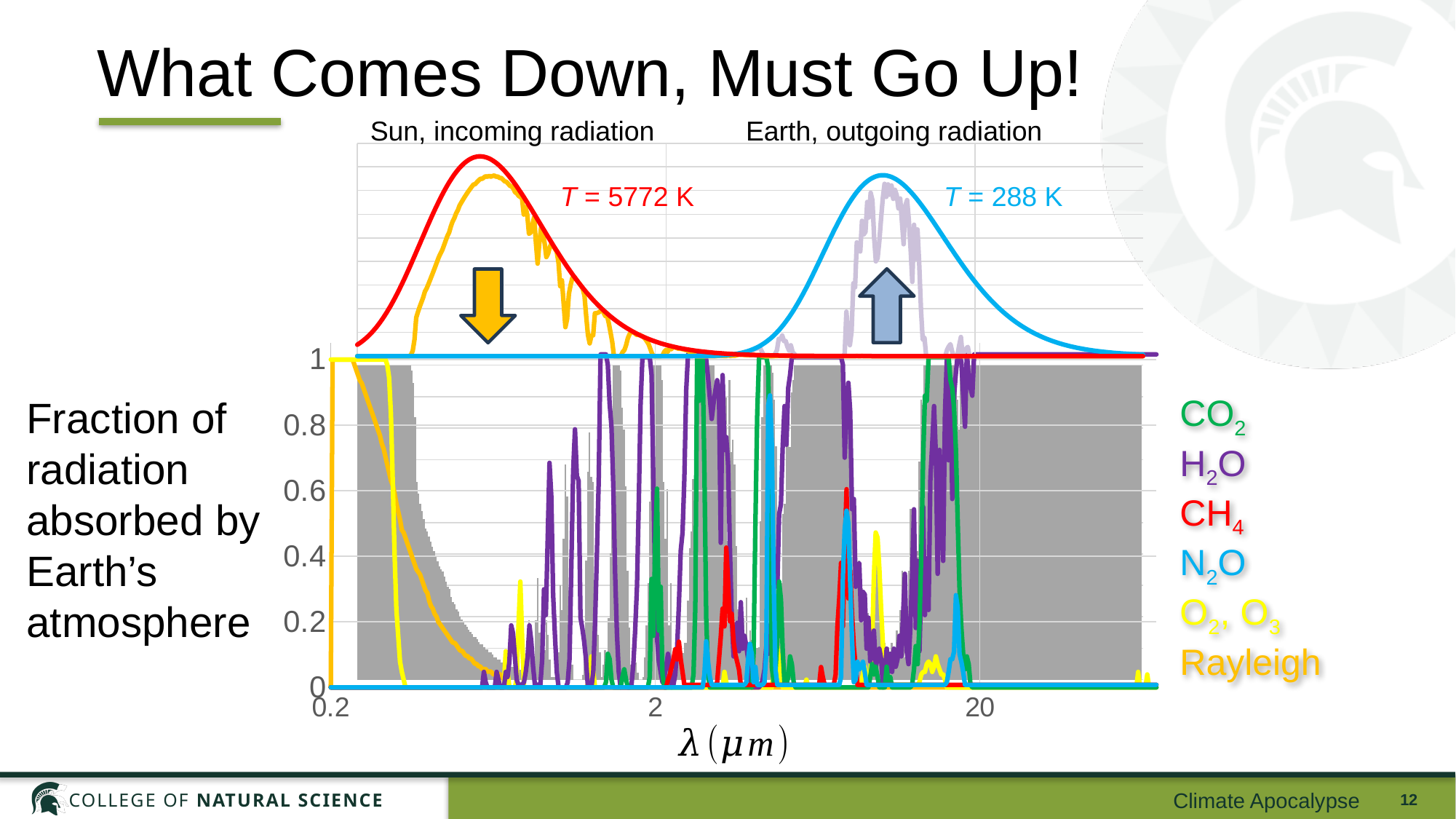
Is the total fraction absorbed (grey area) at 20 μm greater or less than 0.8? greater What kind of chart is shown on the slide? line chart What is the label on the x axis of the chart? λ (μm) What are the tick values printed on the x axis of the absorption chart? 0.2, 2, 20 What is the highest tick value printed on the y axis of the absorption chart? 1 What is the difference between the Sun's labelled temperature and the Earth's labelled temperature? 5484 K What temperature is labelled for the Sun's incoming radiation curve? T = 5772 K Which labelled curve has the higher temperature, the Sun's incoming radiation or the Earth's outgoing radiation? Sun, incoming radiation What temperature is labelled for the Earth's outgoing radiation curve? T = 288 K What colour is the H2O series drawn in on the absorption chart? purple Which radiation curve peaks at the longer wavelength, the Sun's or the Earth's? Earth, outgoing radiation How many gas/scattering series does the legend on the right of the absorption chart list? 6